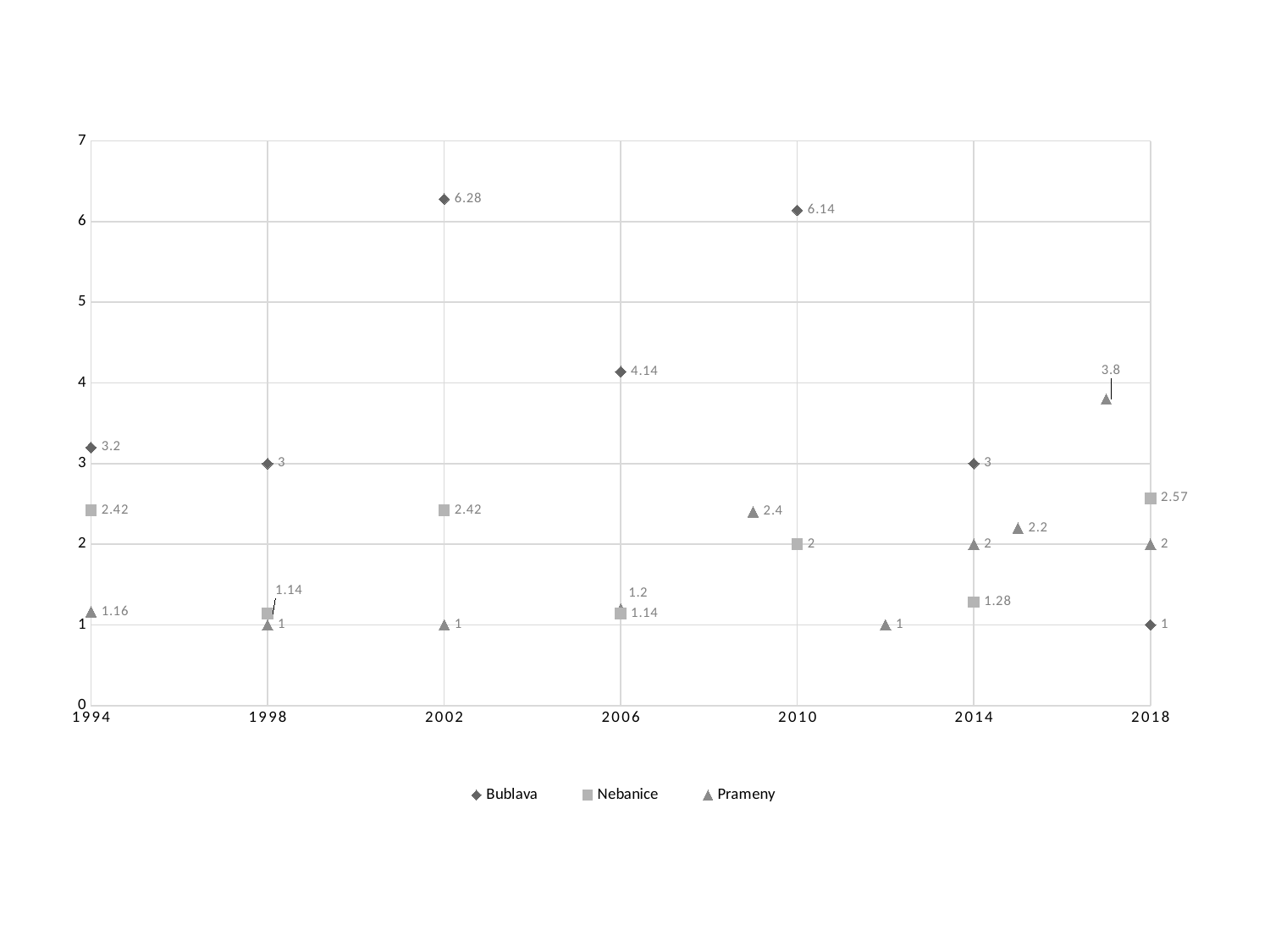
What is the value for Nebanice in 1994? 2.42 What is the value for Bublava in 2010? 6.14 What is the value for Bublava in 2002? 6.28 In 2014, which is larger: the value for Bublava or the value for Nebanice? Bublava In which year does Bublava reach its highest value? 2002 What is the value for Nebanice in 2018? 2.57 What is the highest value plotted for Prameny? 3.8 What kind of chart is shown on the slide? Scatter chart How many series does the legend list? 3 In which year does Bublava have its lowest value? 2018 What is the difference between the Nebanice values in 2018 and 2014? 1.29 What is the difference between the Bublava values in 2002 and 2010? 0.14